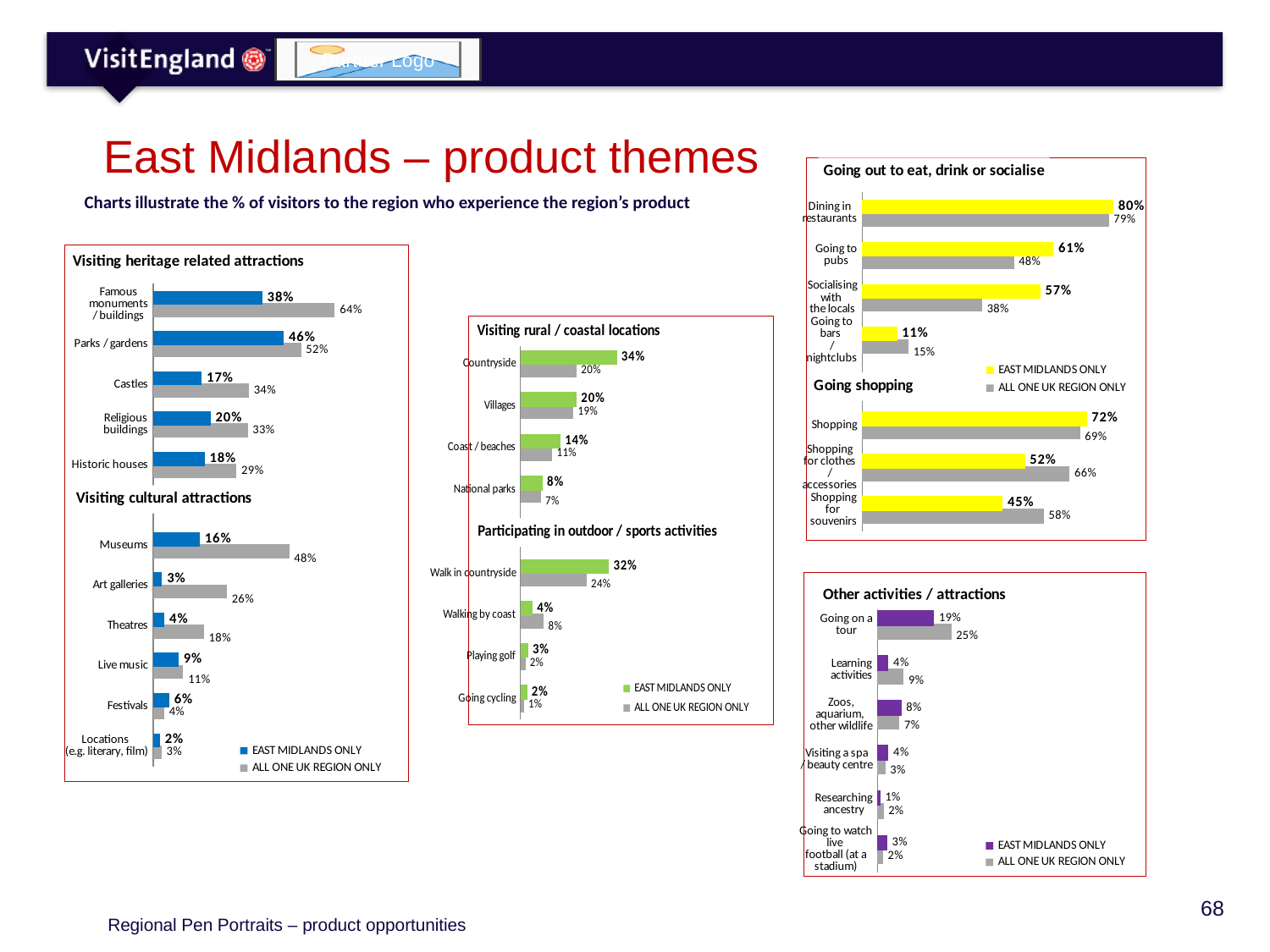
In the 'Visiting cultural attractions' chart, what is the difference between the All one UK region only value and the East Midlands only value for Museums? 32% In the 'Visiting cultural attractions' chart, which category has the highest East Midlands only value? Museums In the 'Going out to eat, drink or socialise' chart, what is the East Midlands only value for Going to pubs? 61% How many series does the legend of the 'Other activities / attractions' chart list? 2 In the 'Going out to eat, drink or socialise' chart, which is larger for Socialising with the locals: the East Midlands only value or the All one UK region only value? East Midlands only In the 'Going shopping' chart, what is the All one UK region only value for Shopping for souvenirs? 58% In the 'Visiting heritage related attractions' chart, what is the All one UK region only value for Famous monuments / buildings? 64% In the 'Other activities / attractions' chart, how many categories are shown? 6 What type of chart is the 'Going shopping' chart? Bar chart In the 'Participating in outdoor / sports activities' chart, which category has the lowest East Midlands only value? Going cycling In the 'Visiting rural / coastal locations' chart, what is the East Midlands only value for Countryside? 34% In the 'Visiting heritage related attractions' chart, what is the East Midlands only value for Parks / gardens? 46%